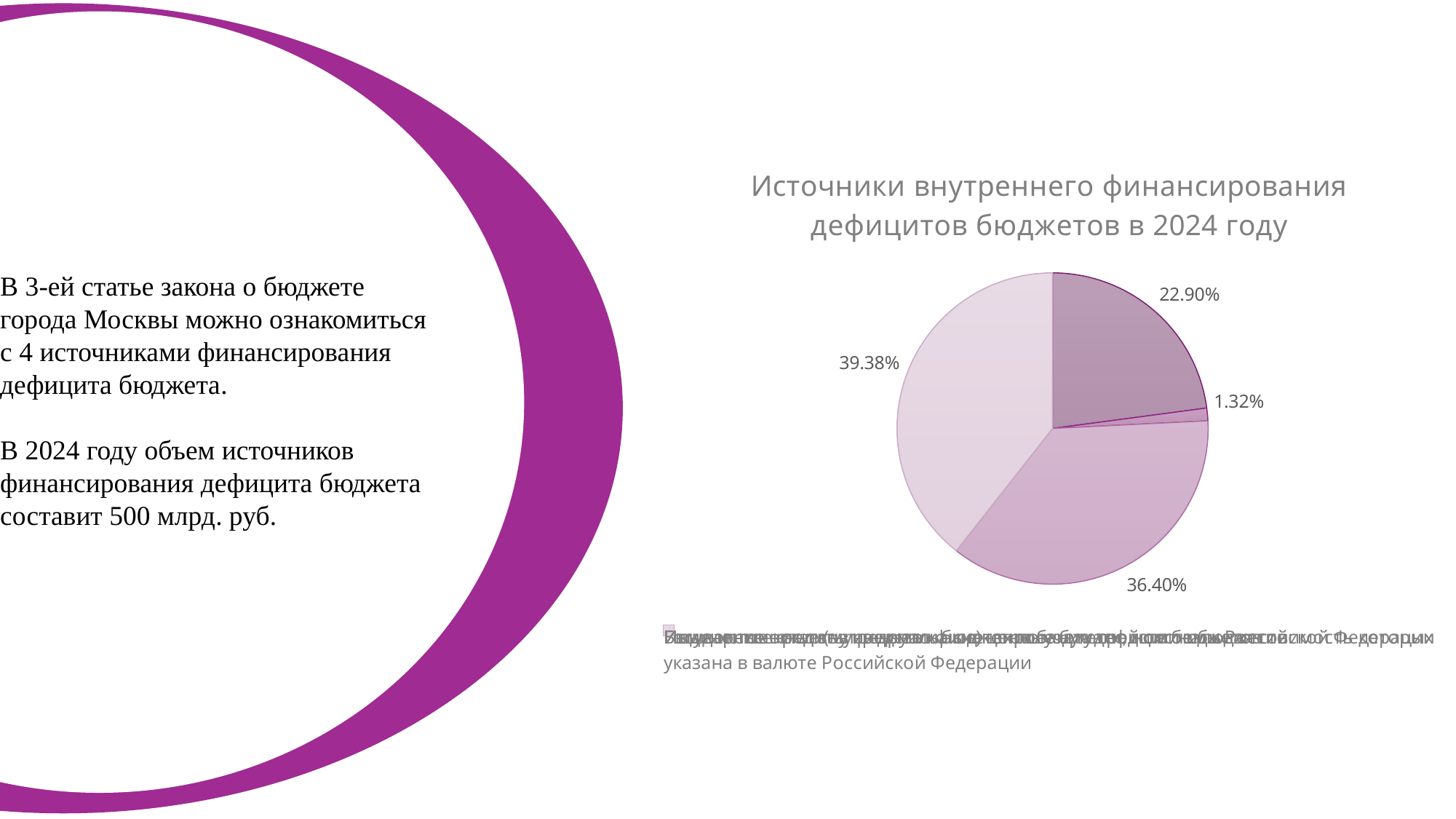
What is the difference between the largest slice (39.38%) and the second-largest slice (36.40%)? 2.98% What is the smallest share shown on the pie chart? 1.32% Is the largest slice of the pie chart greater or less than 50%? less What is the difference between the 22.90% slice and the 1.32% slice? 21.58% What is the title of the chart? Источники внутреннего финансирования дефицитов бюджетов в 2024 году What percentage is labelled on the slice at the bottom of the pie chart? 36.40% How many slices does the pie chart have? 4 Which is larger: the slice labelled 22.90% or the slice labelled 36.40%? 36.40% What is the largest share shown on the pie chart? 39.38% What is the combined share of the two largest slices (39.38% and 36.40%)? 75.78% What kind of chart is shown on the slide? pie chart What percentage is labelled on the slice in the upper right of the pie chart? 22.90%